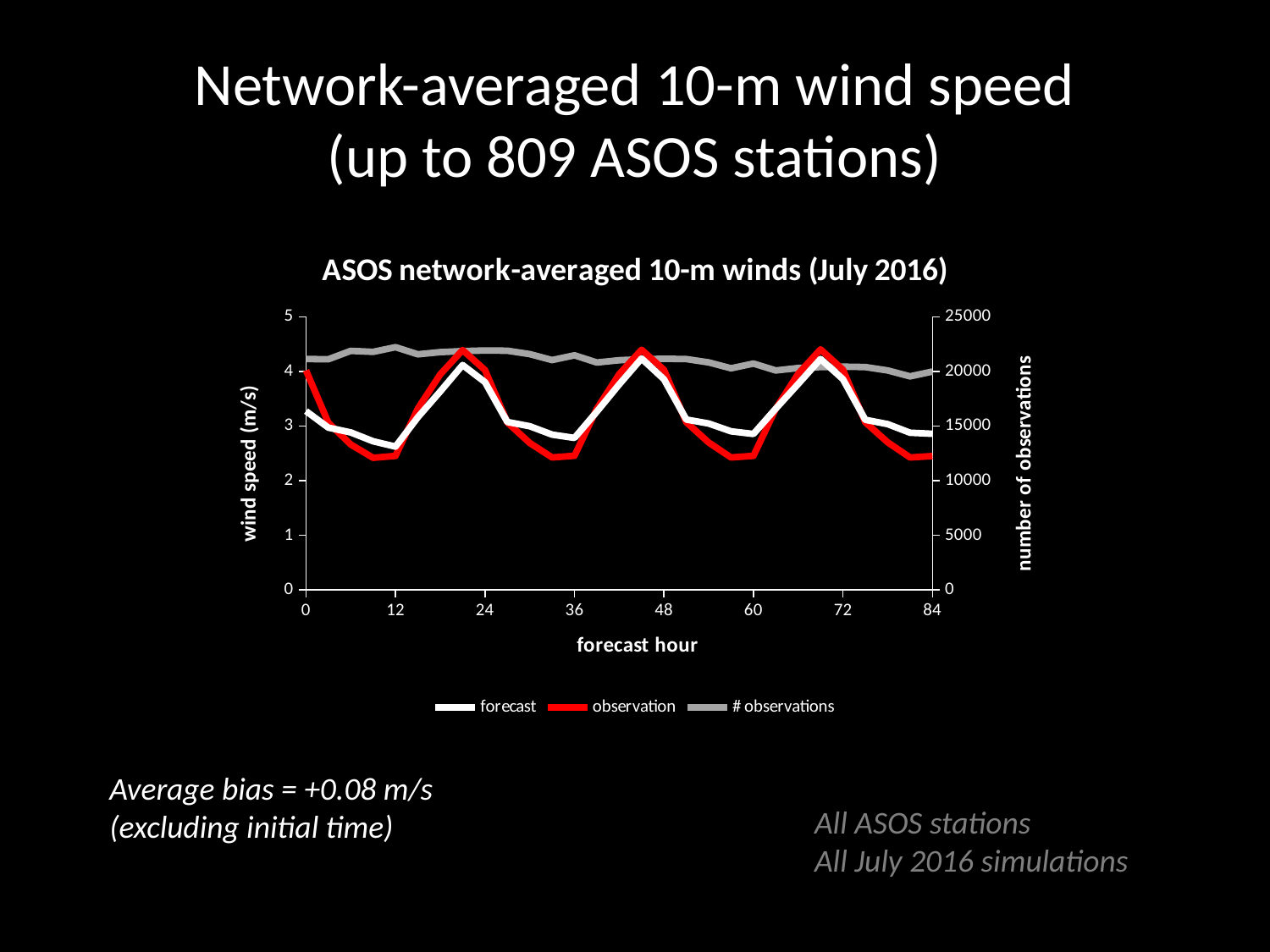
What is the label of the chart's x axis? forecast hour What kind of chart is shown on the slide? line chart Is the # observations value at forecast hour 84 greater or less than 15000? greater Is the observation value at forecast hour 60 greater or less than 3? less How many series does the chart's legend list? 3 Does the # observations series rise or fall overall from forecast hour 0 to forecast hour 84? fall Is the observation value at forecast hour 0 greater or less than 3? greater At forecast hour 0, which is larger, the forecast or the observation? observation At forecast hour 36, which is larger, the forecast or the observation? forecast What is the title of the chart? ASOS network-averaged 10-m winds (July 2016)